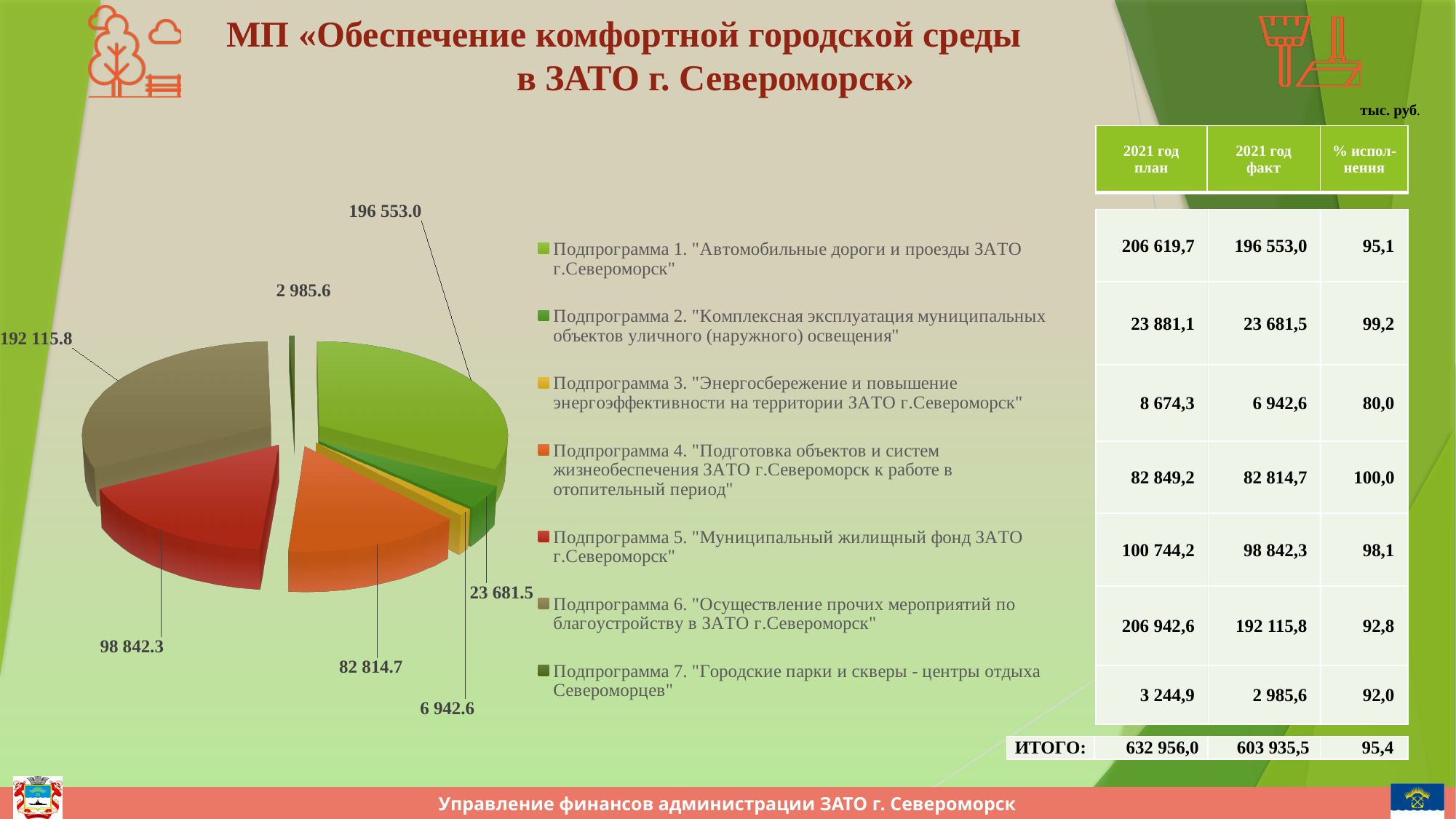
What is the value shown for Подпрограмма 3 "Энергосбережение и повышение энергоэффективности" on the pie chart? 6 942.6 What type of chart is shown on the slide? Pie chart Which subprogram has the smallest slice in the pie chart? Подпрограмма 7 "Городские парки и скверы - центры отдыха Североморцев" What is the value shown for Подпрограмма 5 "Муниципальный жилищный фонд ЗАТО г.Североморск" on the pie chart? 98 842.3 What is the difference between the values for Подпрограмма 1 (196 553.0) and Подпрограмма 6 (192 115.8) on the pie chart? 4 437.2 What is the total of all values shown on the pie chart? 603 935.5 What is the value shown for Подпрограмма 7 "Городские парки и скверы" on the pie chart? 2 985.6 What colour is the slice for Подпрограмма 6 "Осуществление прочих мероприятий по благоустройству" in the pie chart? Grey-brown (taupe) Which is larger on the pie chart: the value for Подпрограмма 5 or the value for Подпрограмма 4? Подпрограмма 5 How many slices (subprograms) does the pie chart have? 7 What is the value shown for Подпрограмма 1 "Автомобильные дороги и проезды ЗАТО г.Североморск" on the pie chart? 196 553.0 Which subprogram has the largest slice in the pie chart? Подпрограмма 1 "Автомобильные дороги и проезды ЗАТО г.Североморск"